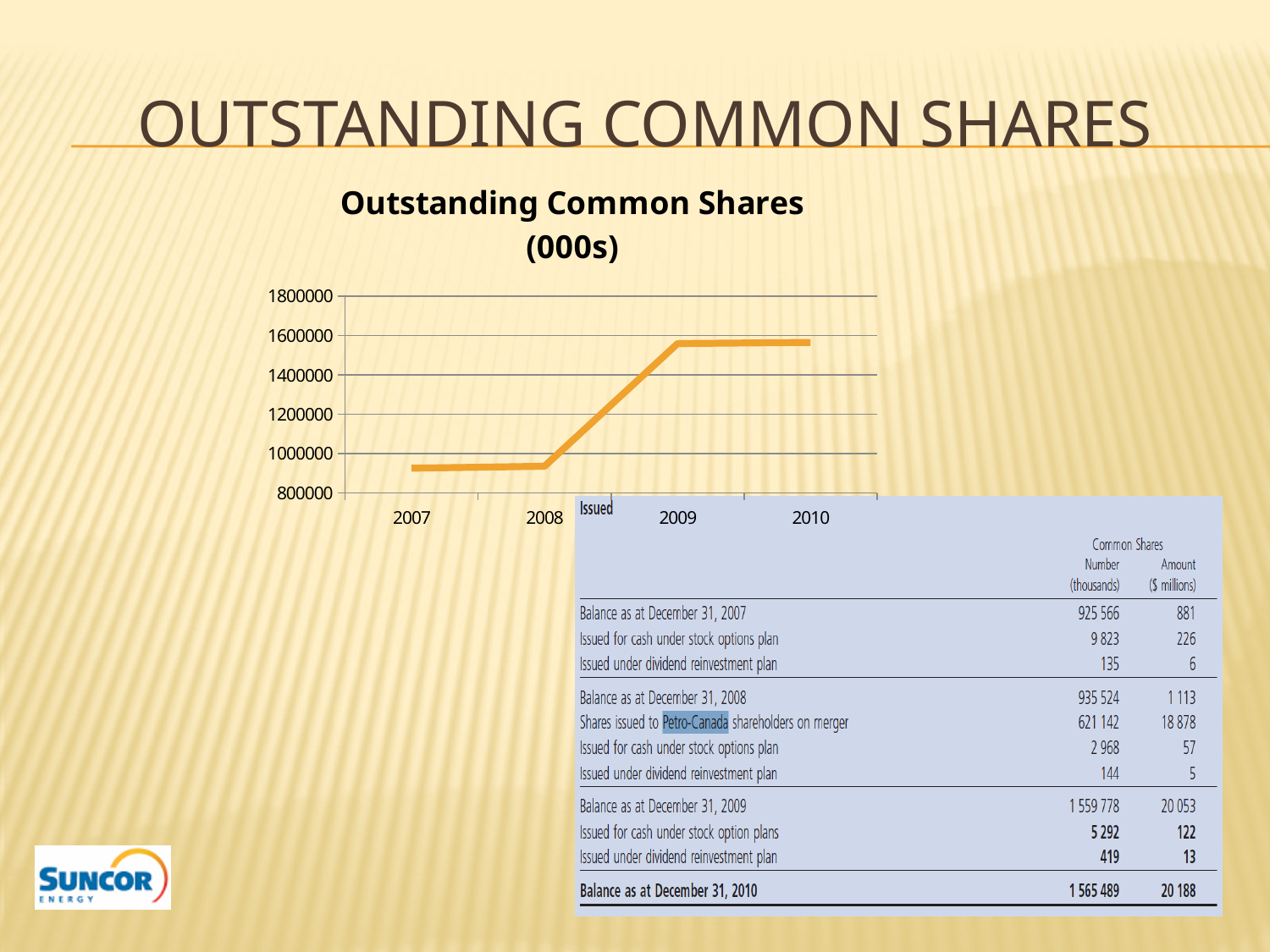
Between which two consecutive years does the line show the largest increase? 2008 and 2009 Which is larger, the value for 2008 or the value for 2009? 2009 How many years are plotted on the x axis of the chart? 4 What is the title of the chart? Outstanding Common Shares (000s) Do the values rise or fall from 2007 to 2010? rise What kind of chart is shown on the slide? line chart Which is larger, the value for 2007 or the value for 2010? 2010 Is the value for 2008 greater or less than 1000000? less Is the value for 2010 greater or less than 1200000? greater Is the value for 2009 greater or less than 1400000? greater